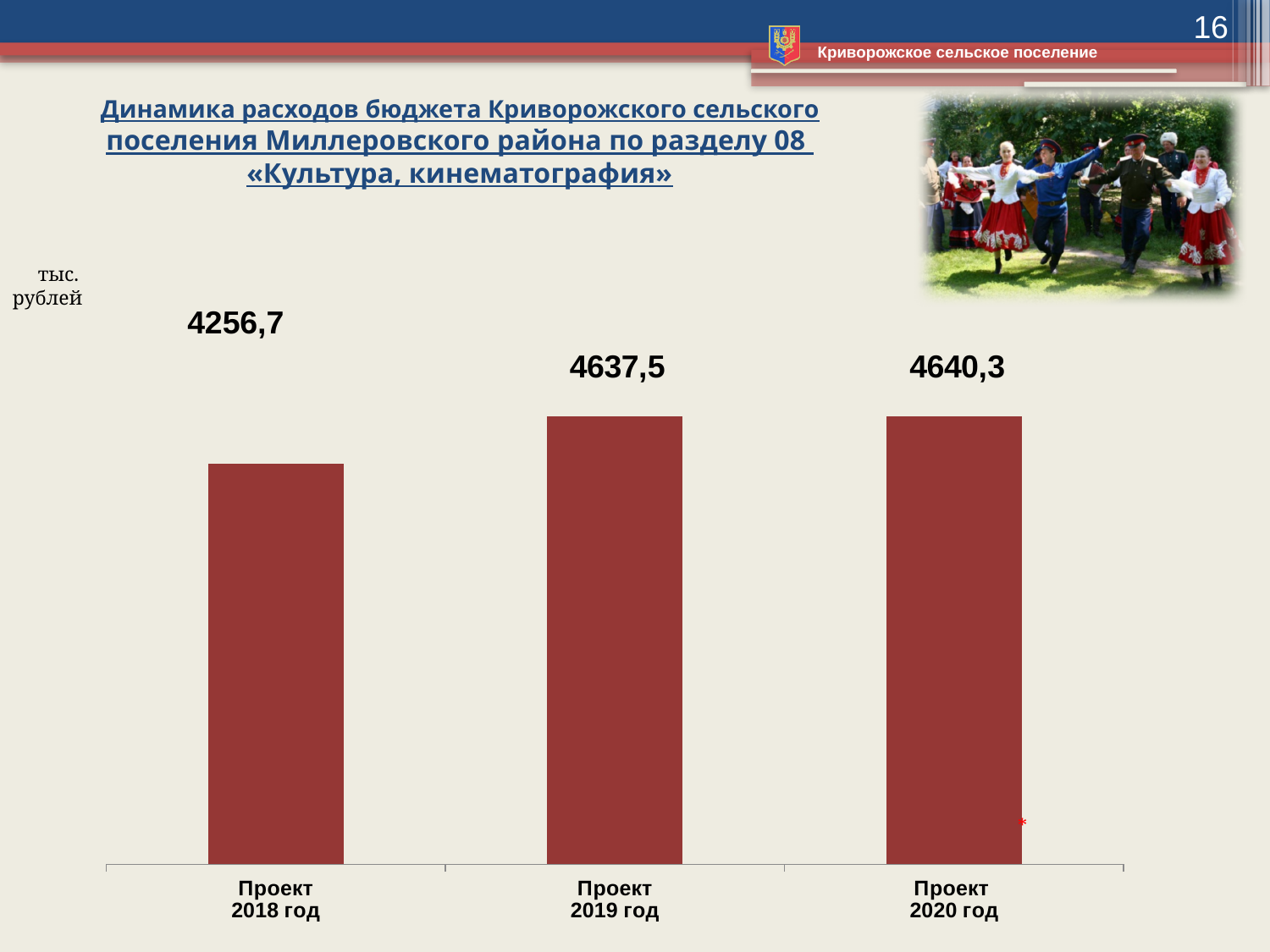
Which is larger, the value for Проект 2019 год or Проект 2018 год? Проект 2019 год Which category has the lowest value? Проект 2018 год What kind of chart is shown on the slide? bar chart How many categories are shown in the chart? 3 What is the difference between the values for Проект 2020 год and Проект 2019 год? 2,8 What is the value for Проект 2019 год? 4637,5 What is the difference between the values for Проект 2019 год and Проект 2018 год? 380,8 Do the values rise or fall from Проект 2018 год to Проект 2020 год? rise In what units are the chart values given? тыс. рублей What is the value for Проект 2018 год? 4256,7 Which category has the highest value? Проект 2020 год What is the value for Проект 2020 год? 4640,3